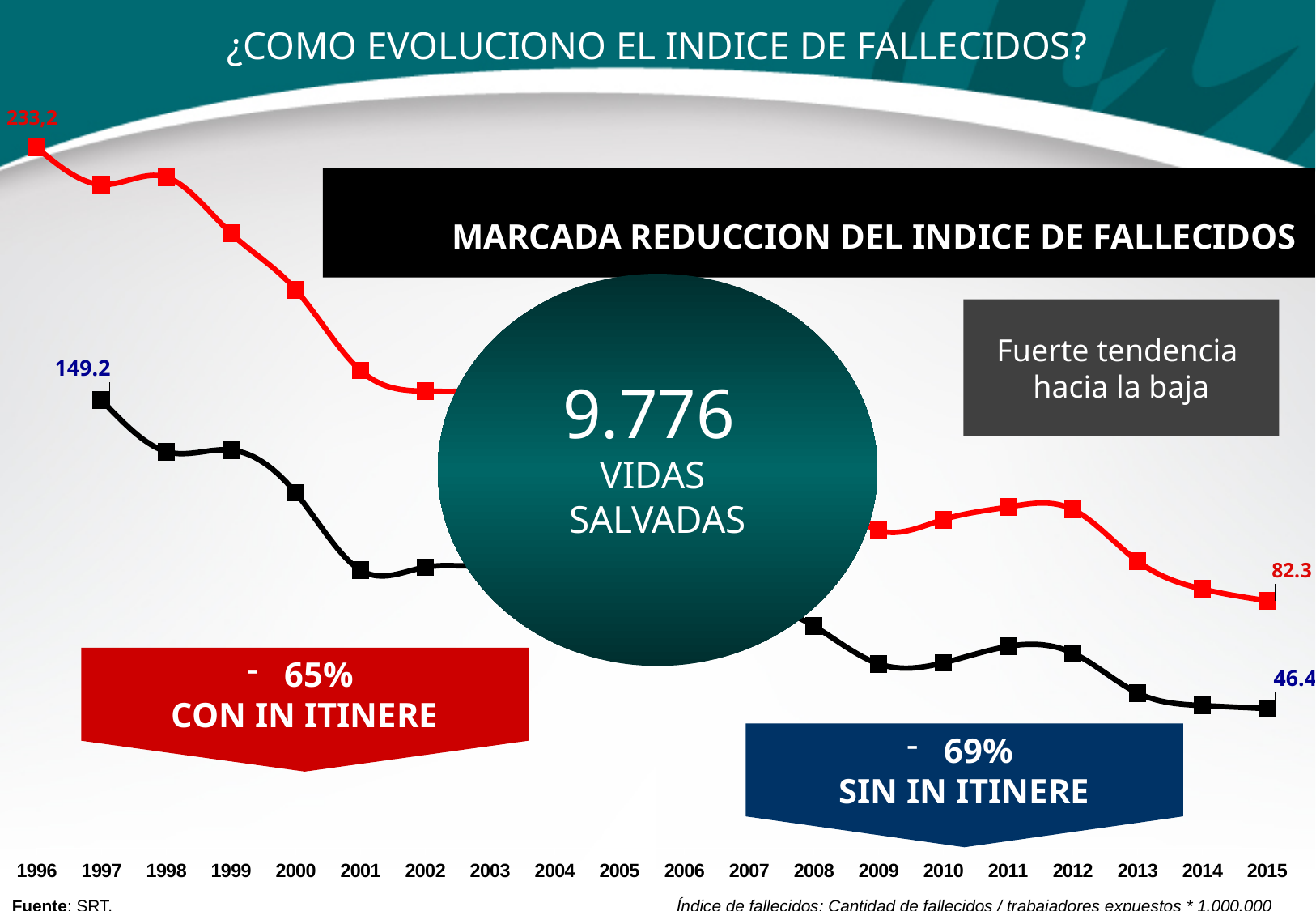
What is the first labelled value of the black line, in 1997? 149.2 What is the difference between the red line and the black line in 2015? 35.9 How many years are shown on the x axis? 20 What percentage reduction is shown for 'CON IN ITINERE'? -65% What kind of chart is shown on the slide? line chart In which year does the red line reach its highest value? 1996 In 2015, which line has the higher value, the red line or the black line? the red line What is the value of the red line in 2015? 82.3 What is the value of the red line in 1996? 233,2 Do the values of the red line rise or fall overall from 1996 to 2015? fall What is the value of the black line in 2015? 46.4 In which year does the black line reach its lowest value? 2015